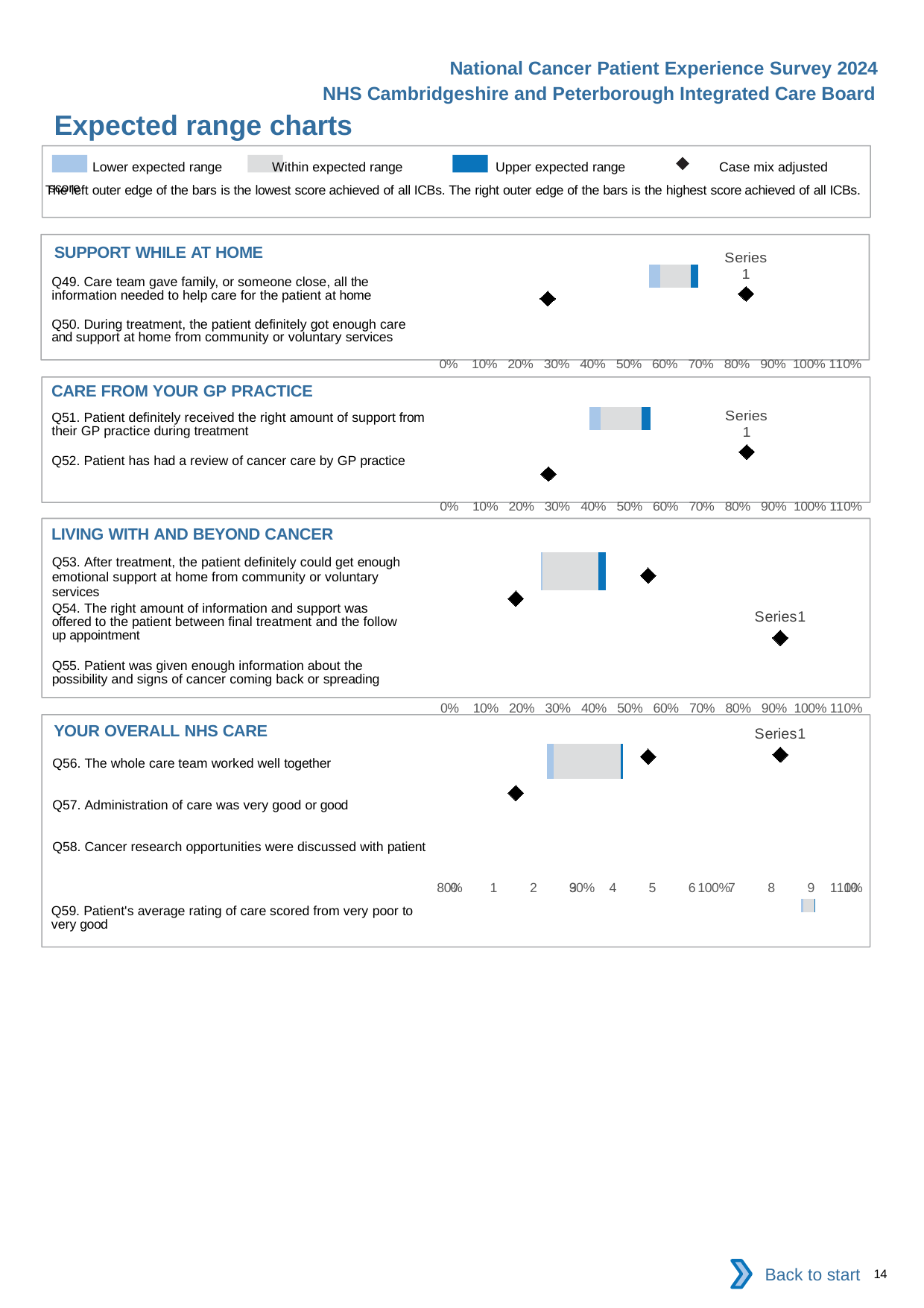
How many entries does the legend at the top of the slide list? 4 What is the title of the slide? Expected range charts According to the legend, which colour represents the upper expected range? dark blue In the CARE FROM YOUR GP PRACTICE chart, is the leftmost diamond marker greater or less than 40%? less In the SUPPORT WHILE AT HOME chart, is the rightmost diamond marker greater or less than 70%? greater How many questions are listed in the YOUR OVERALL NHS CARE chart? 4 In the LIVING WITH AND BEYOND CANCER chart, is the rightmost diamond marker greater or less than 80%? greater How many questions are listed in the CARE FROM YOUR GP PRACTICE chart? 2 What kind of chart is used in the SUPPORT WHILE AT HOME section? bar chart How many questions are listed in the SUPPORT WHILE AT HOME chart? 2